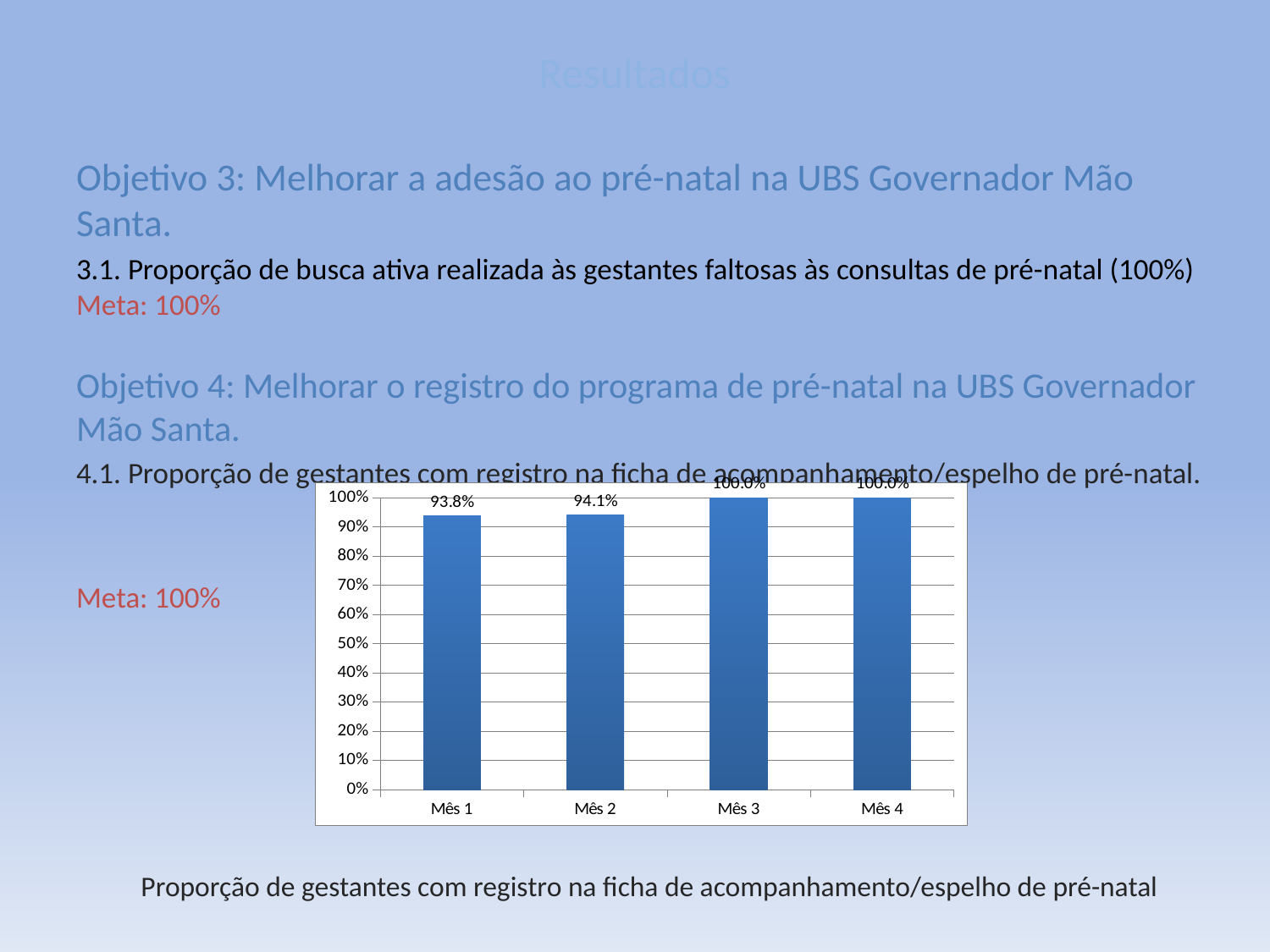
What is the value for Mês 1? 93.8% What kind of chart is shown on the slide? bar chart Do the values rise or fall from Mês 1 to Mês 4? rise How many months are shown on the x axis? 4 Which is larger, the value for Mês 3 or the value for Mês 2? Mês 3 What is the value for Mês 4? 100.0% Is the value for Mês 1 greater or less than 90%? greater What is the value for Mês 2? 94.1% What is the difference between the values for Mês 2 and Mês 1? 0.3% What is the difference between the values for Mês 3 and Mês 1? 6.2% Which month has the lowest value? Mês 1 What is the value for Mês 3? 100.0%